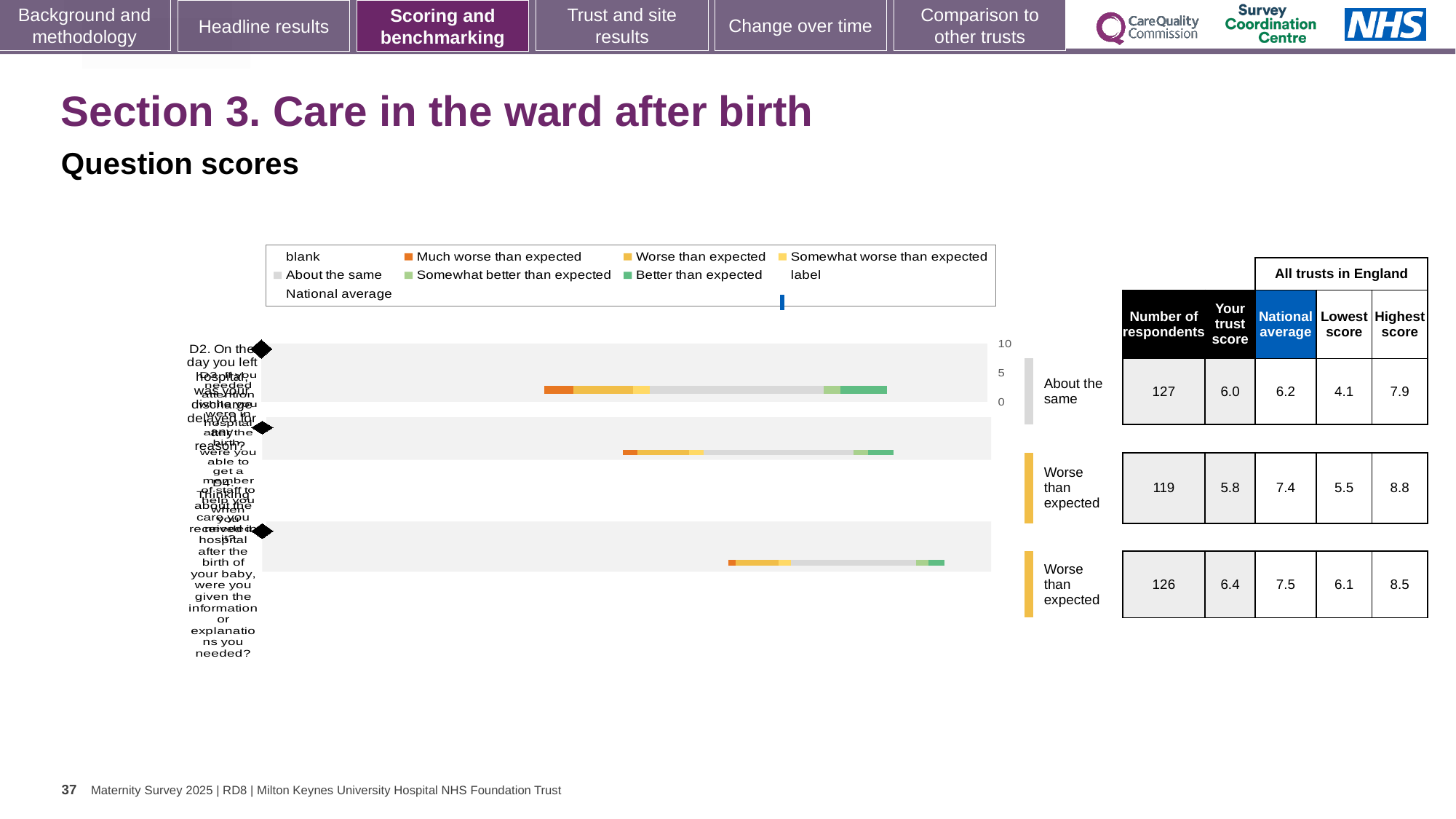
In the chart legend, which colour represents 'Better than expected'? green What is the highest value shown on the chart's score axis? 10 How many question bars are plotted in the chart? 3 In the chart legend, which colour represents 'Much worse than expected'? orange What rating label is shown beside the top bar of the chart? About the same How many of the three question bars are rated 'Worse than expected'? 2 What rating label is shown beside the bottom bar of the chart? Worse than expected What kind of chart is shown on the slide? bar chart